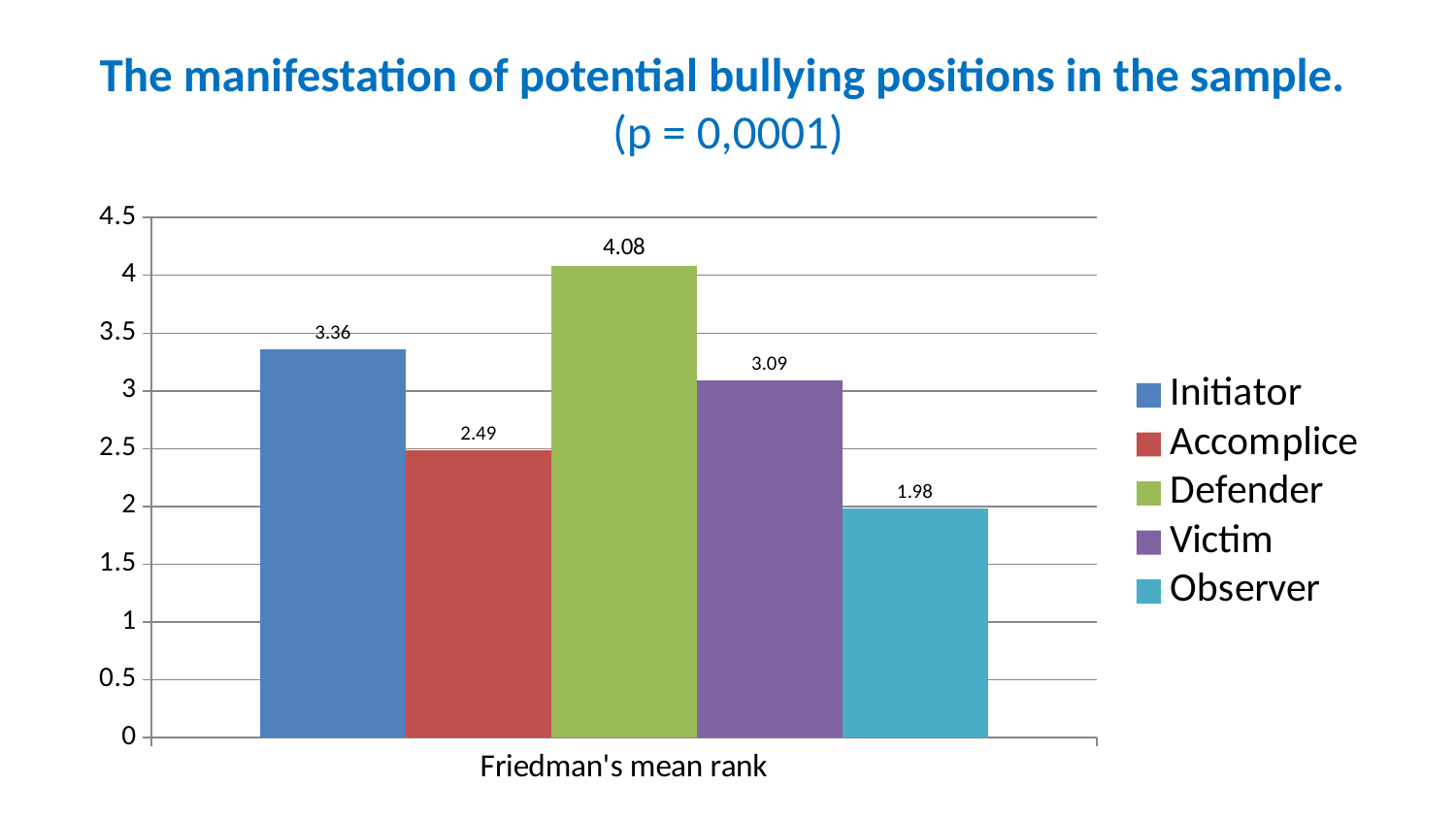
Which bullying position has the highest Friedman's mean rank? Defender Is the value for Accomplice greater or less than 3? less What colour is the bar for Defender? green What is the Friedman's mean rank for Observer? 1.98 Which bullying position has the lowest Friedman's mean rank? Observer What is the label on the x axis of the chart? Friedman's mean rank What is the Friedman's mean rank for Initiator? 3.36 Which has a higher Friedman's mean rank, Initiator or Victim? Initiator How many series does the legend list? 5 What kind of chart is shown on the slide? bar chart What is the Friedman's mean rank for Accomplice? 2.49 What is the difference between the mean rank for Defender and the mean rank for Victim? 0.99